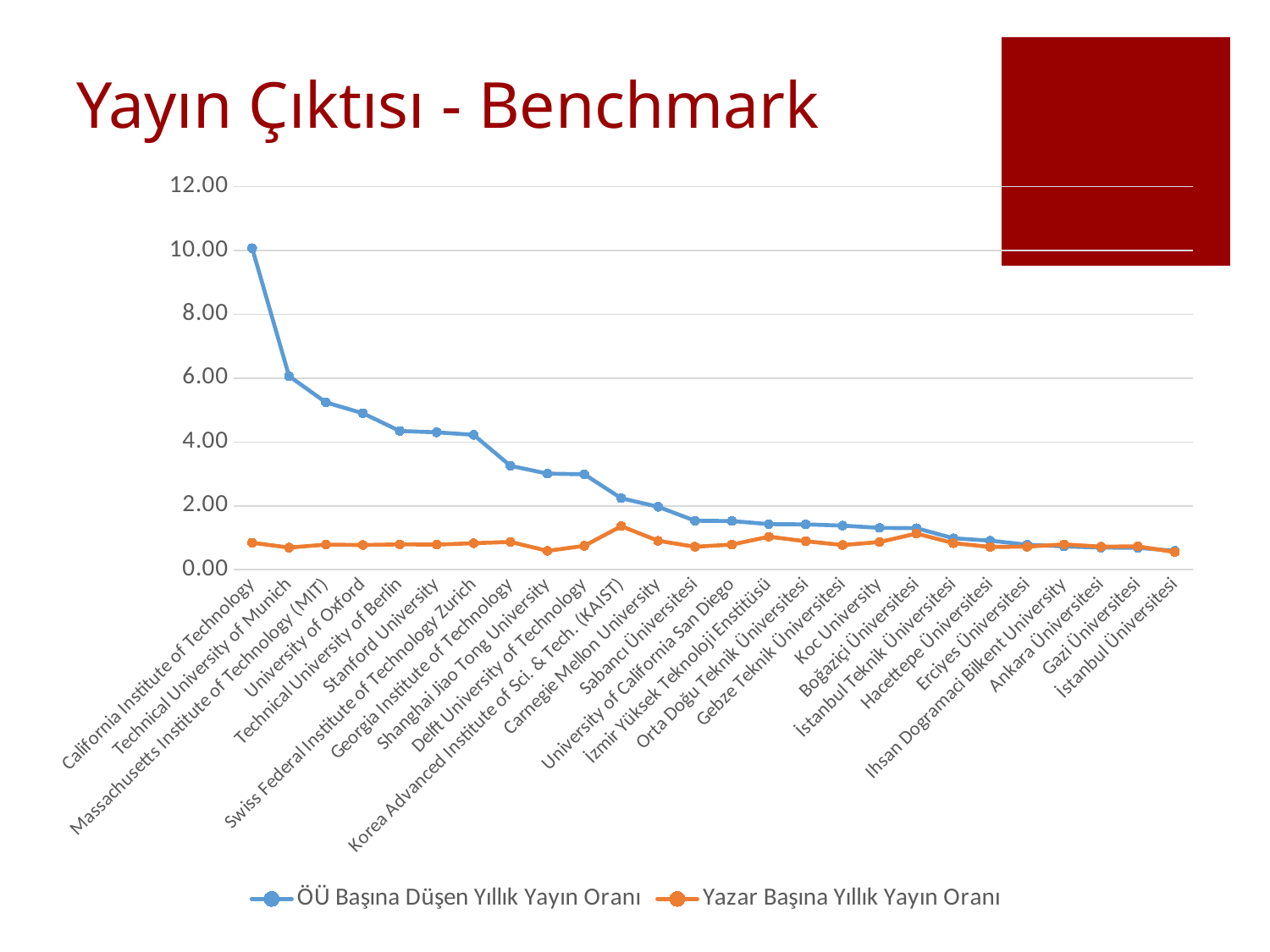
Is the ÖÜ Başına Düşen Yıllık Yayın Oranı value for Technical University of Munich greater or less than 4.00? greater Is the ÖÜ Başına Düşen Yıllık Yayın Oranı value for Carnegie Mellon University greater or less than 4.00? less How many series does the legend list? 2 Do the values for ÖÜ Başına Düşen Yıllık Yayın Oranı generally rise or fall from left to right along the x axis? fall Which university has the highest value for ÖÜ Başına Düşen Yıllık Yayın Oranı? California Institute of Technology Which is larger for ÖÜ Başına Düşen Yıllık Yayın Oranı: California Institute of Technology or Massachusetts Institute of Technology (MIT)? California Institute of Technology Is the ÖÜ Başına Düşen Yıllık Yayın Oranı value for California Institute of Technology greater or less than 8.00? greater For California Institute of Technology, which series has the larger value: ÖÜ Başına Düşen Yıllık Yayın Oranı or Yazar Başına Yıllık Yayın Oranı? ÖÜ Başına Düşen Yıllık Yayın Oranı How many universities are plotted along the x axis? 26 What kind of chart is shown on the slide? line chart What is the title of the slide containing the chart? Yayın Çıktısı - Benchmark